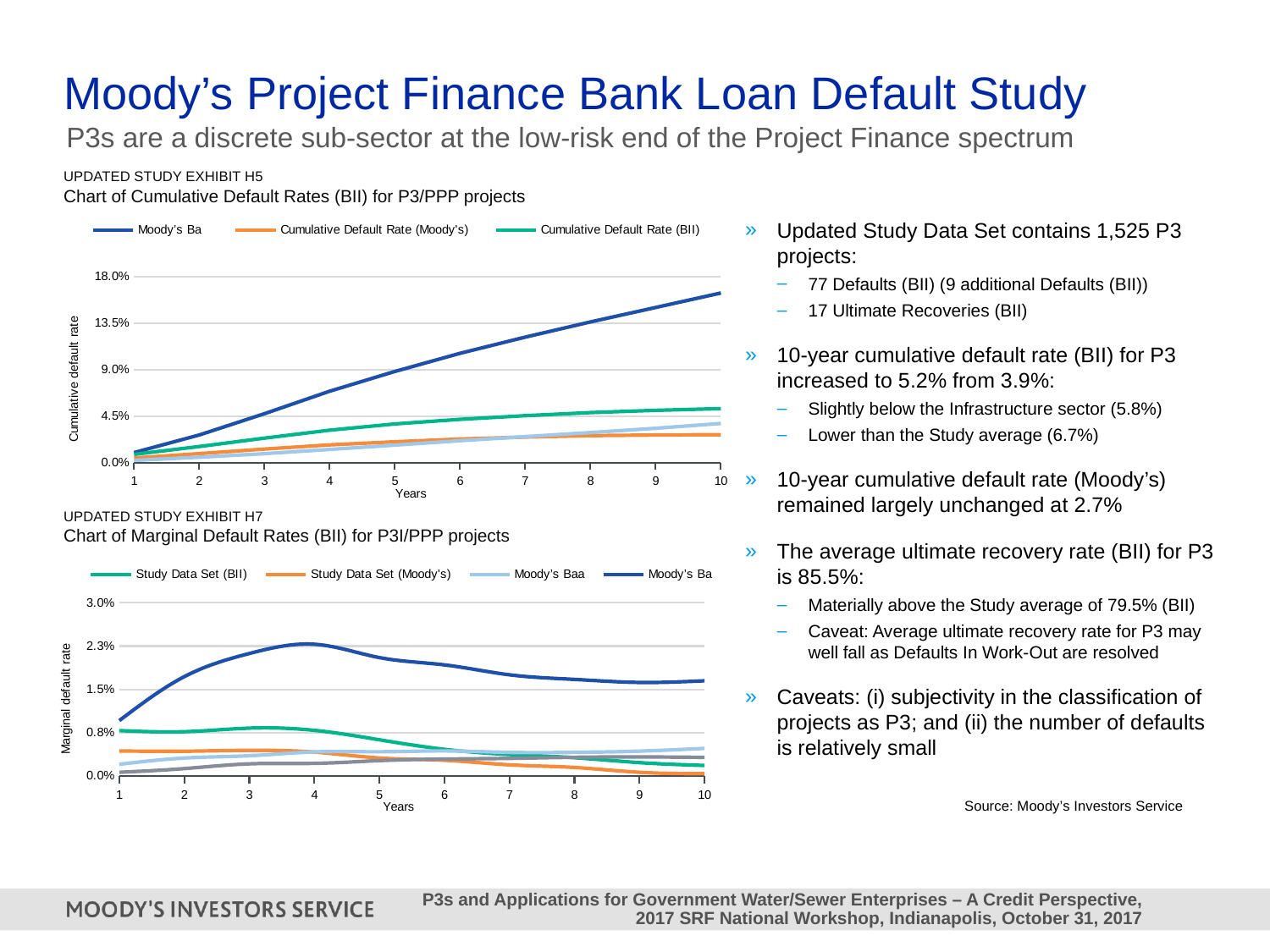
In Exhibit H7 (Marginal Default Rates), is the value for Moody's Ba at year 10 greater or less than 1.5%? greater How many years are shown on the x axis of Exhibit H5 (Cumulative Default Rates)? 10 In Exhibit H5 (Cumulative Default Rates), is the value for Cumulative Default Rate (Moody's) at year 10 greater or less than 4.5%? less In Exhibit H5 (Cumulative Default Rates), which is larger at year 10: Cumulative Default Rate (BII) or Cumulative Default Rate (Moody's)? Cumulative Default Rate (BII) What is the y-axis label of Exhibit H7 (Marginal Default Rates)? Marginal default rate In Exhibit H5 (Cumulative Default Rates), which series has the highest value at year 10? Moody's Ba In Exhibit H7 (Marginal Default Rates), which series has the highest value at year 4? Moody's Ba What kind of chart is Exhibit H5, the Chart of Cumulative Default Rates (BII) for P3/PPP projects? Line chart In Exhibit H5 (Cumulative Default Rates), is the value for Moody's Ba at year 10 greater or less than 13.5%? greater In Exhibit H5 (Cumulative Default Rates), does the Moody's Ba series rise or fall from year 1 to year 10? Rise How many series does the legend of Exhibit H5 (Cumulative Default Rates) list? 3 How many series does the legend of Exhibit H7 (Marginal Default Rates) list? 4